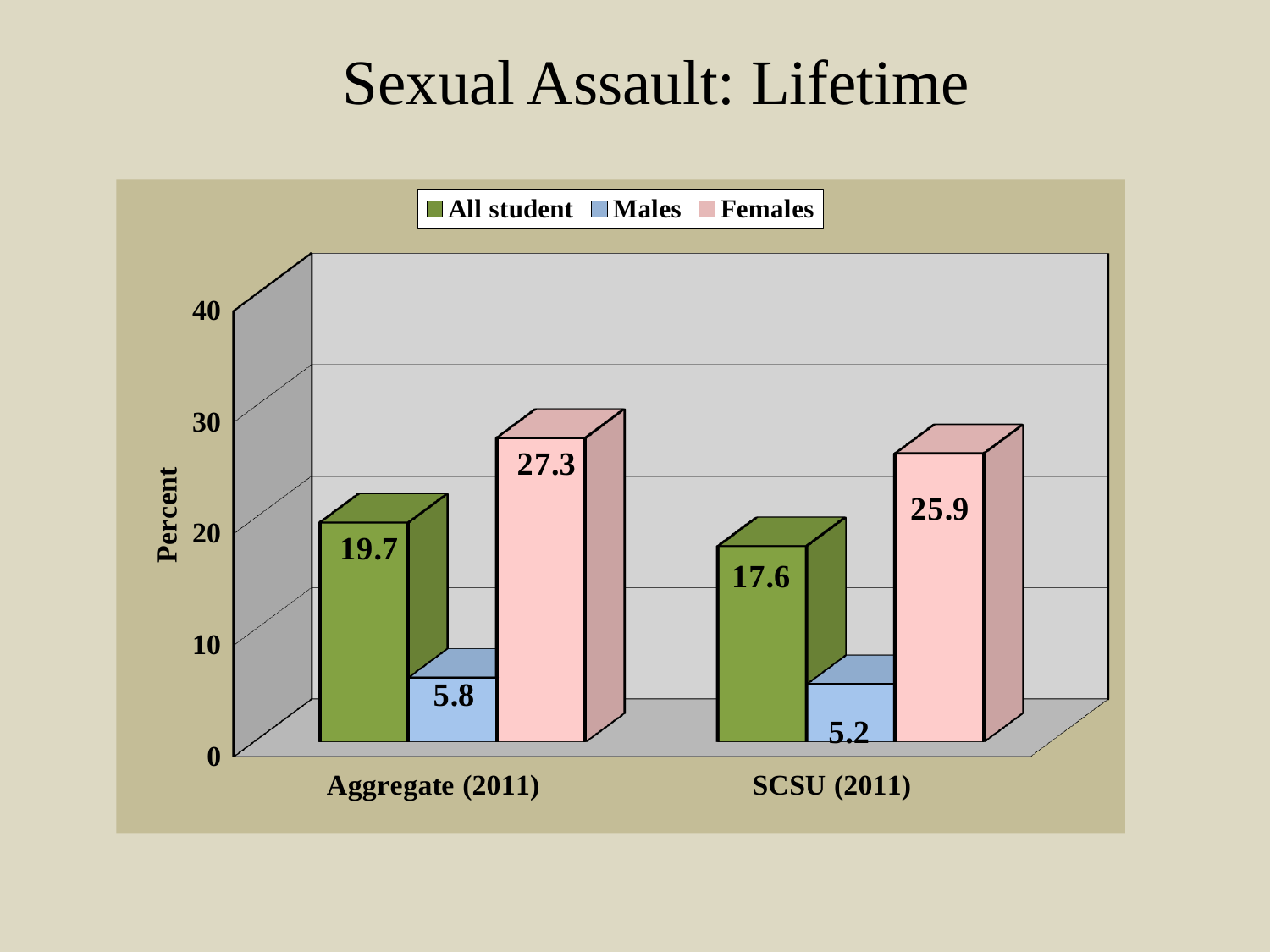
What kind of chart is shown on the slide? Bar chart Which series has the highest value in the Aggregate (2011) group? Females What is the difference between the All student values for Aggregate (2011) and SCSU (2011)? 2.1 What is the difference between the Females and Males values in the Aggregate (2011) group? 21.5 Which is larger, the Females value for Aggregate (2011) or for SCSU (2011)? Aggregate (2011) Which series has the lowest value in the SCSU (2011) group? Males How many categories are shown on the x axis? 2 How many series does the legend list? 3 What is the value for All student in the SCSU (2011) group? 17.6 What is the value for Males in the SCSU (2011) group? 5.2 What is the label of the vertical axis? Percent What is the value for Females in the Aggregate (2011) group? 27.3